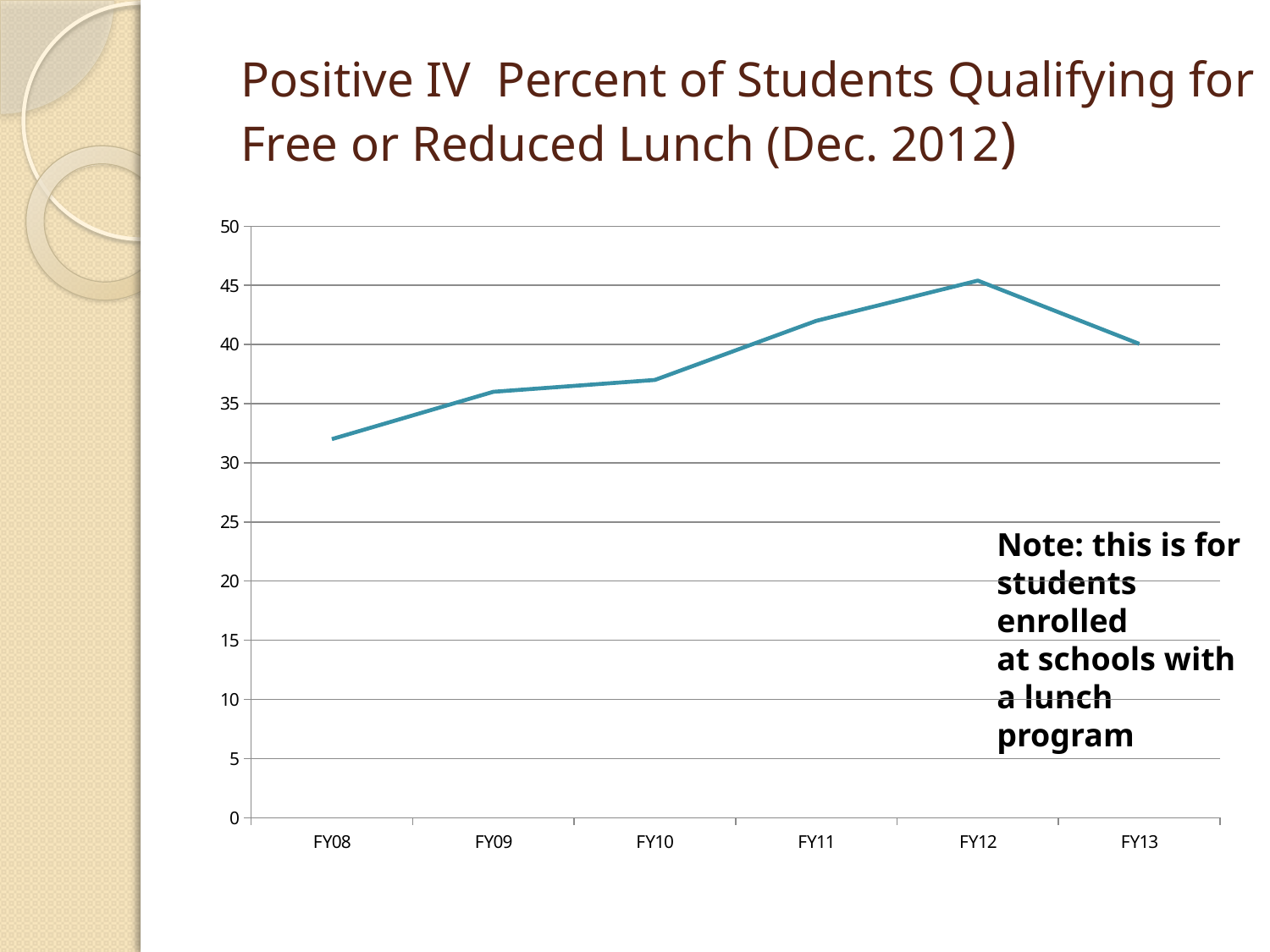
How many fiscal years are plotted on the x axis? 6 Which is larger, the value for FY11 or the value for FY09? FY11 How does the line change from FY08 to FY12? It rises Which fiscal year has the lowest percent of students qualifying for free or reduced lunch? FY08 Which fiscal year has the highest percent of students qualifying for free or reduced lunch? FY12 Is the value for FY10 greater or less than 40? less Which is larger, the value for FY13 or the value for FY08? FY13 What is the title of the chart on the slide? Positive IV Percent of Students Qualifying for Free or Reduced Lunch (Dec. 2012) Is the value for FY08 greater or less than 35? less Is the value for FY11 greater or less than 40? greater What kind of chart is shown on the slide? Line chart